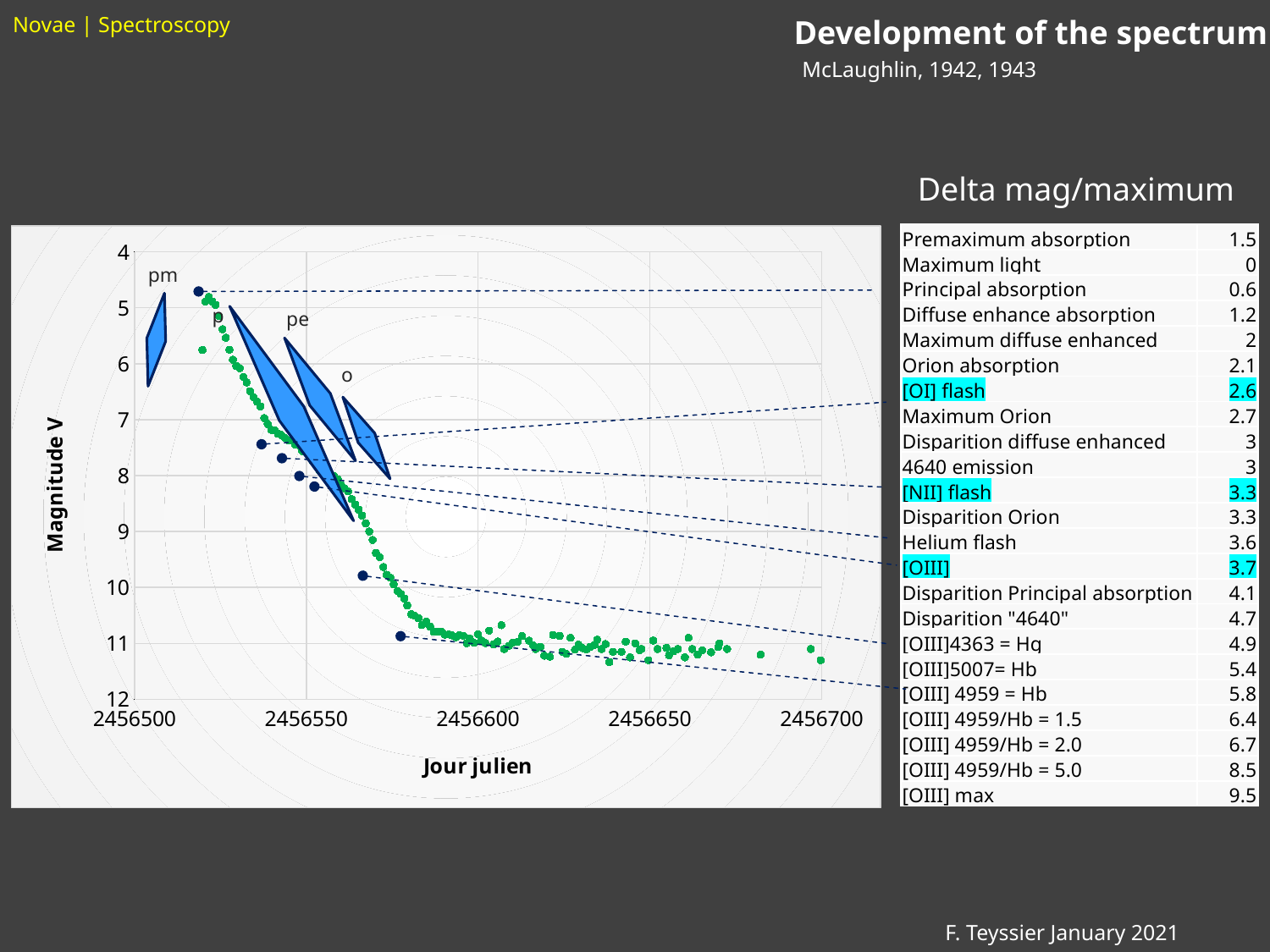
Is the smallest magnitude value plotted on the chart greater or less than 5? less How many labelled shaded regions (pm, p, pe, o) are drawn on the chart? 4 What kind of chart is shown on the slide? scatter chart What is the title of the y axis of the chart? Magnitude V Is the magnitude value of the green points near Jour julien 2456600 greater or less than 9? greater Is the magnitude value of the green points near Jour julien 2456700 greater or less than 10? greater Do the plotted magnitude values increase or decrease as Jour julien increases? increase What is the highest tick value shown on the x axis of the chart? 2456700 What is the lowest tick value shown on the x axis of the chart? 2456500 What is the largest magnitude value shown on the y axis of the chart? 12 What is the title of the x axis of the chart? Jour julien How many tick labels are shown on the x axis of the chart? 5